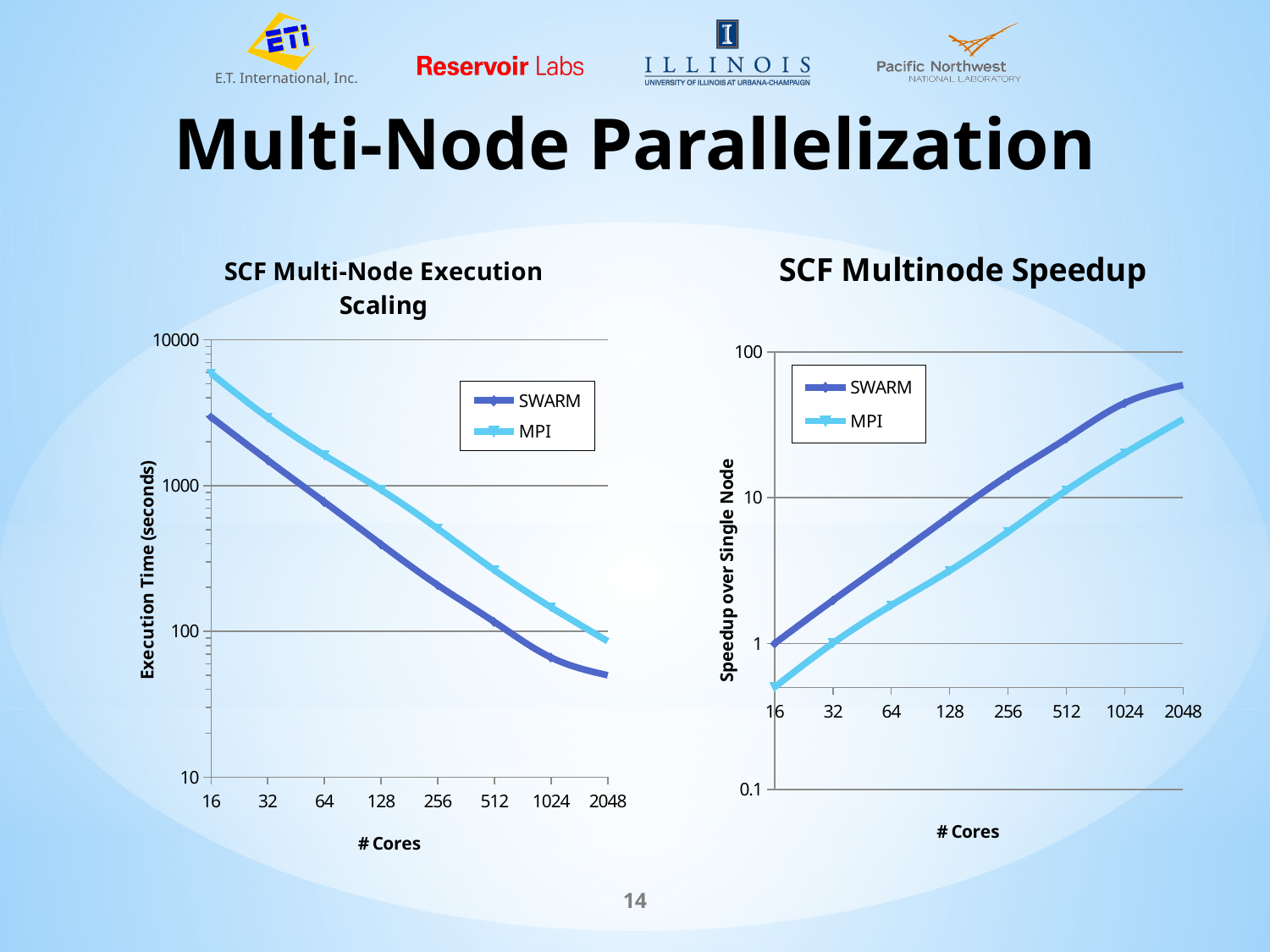
In the SCF Multi-Node Execution Scaling chart, at 256 cores, which series has the higher execution time, SWARM or MPI? MPI In the SCF Multinode Speedup chart, does the MPI speedup rise or fall as the number of cores increases? rise In the SCF Multi-Node Execution Scaling chart, is the SWARM execution time at 2048 cores greater or less than 100 seconds? less In the SCF Multi-Node Execution Scaling chart, is the SWARM execution time at 16 cores greater or less than 1000 seconds? greater In the SCF Multi-Node Execution Scaling chart, what kind of chart is shown? line chart In the SCF Multi-Node Execution Scaling chart, does the SWARM execution time rise or fall as the number of cores increases? fall In the SCF Multinode Speedup chart, how many series does the legend list? 2 In the SCF Multinode Speedup chart, what is the label of the y axis? Speedup over Single Node In the SCF Multinode Speedup chart, at 256 cores, which series has the higher speedup, SWARM or MPI? SWARM In the SCF Multi-Node Execution Scaling chart, how many core counts are marked on the x axis? 8 In the SCF Multinode Speedup chart, what is the SWARM speedup at 16 cores? 1 In the SCF Multinode Speedup chart, is the SWARM speedup at 2048 cores greater or less than 10? greater